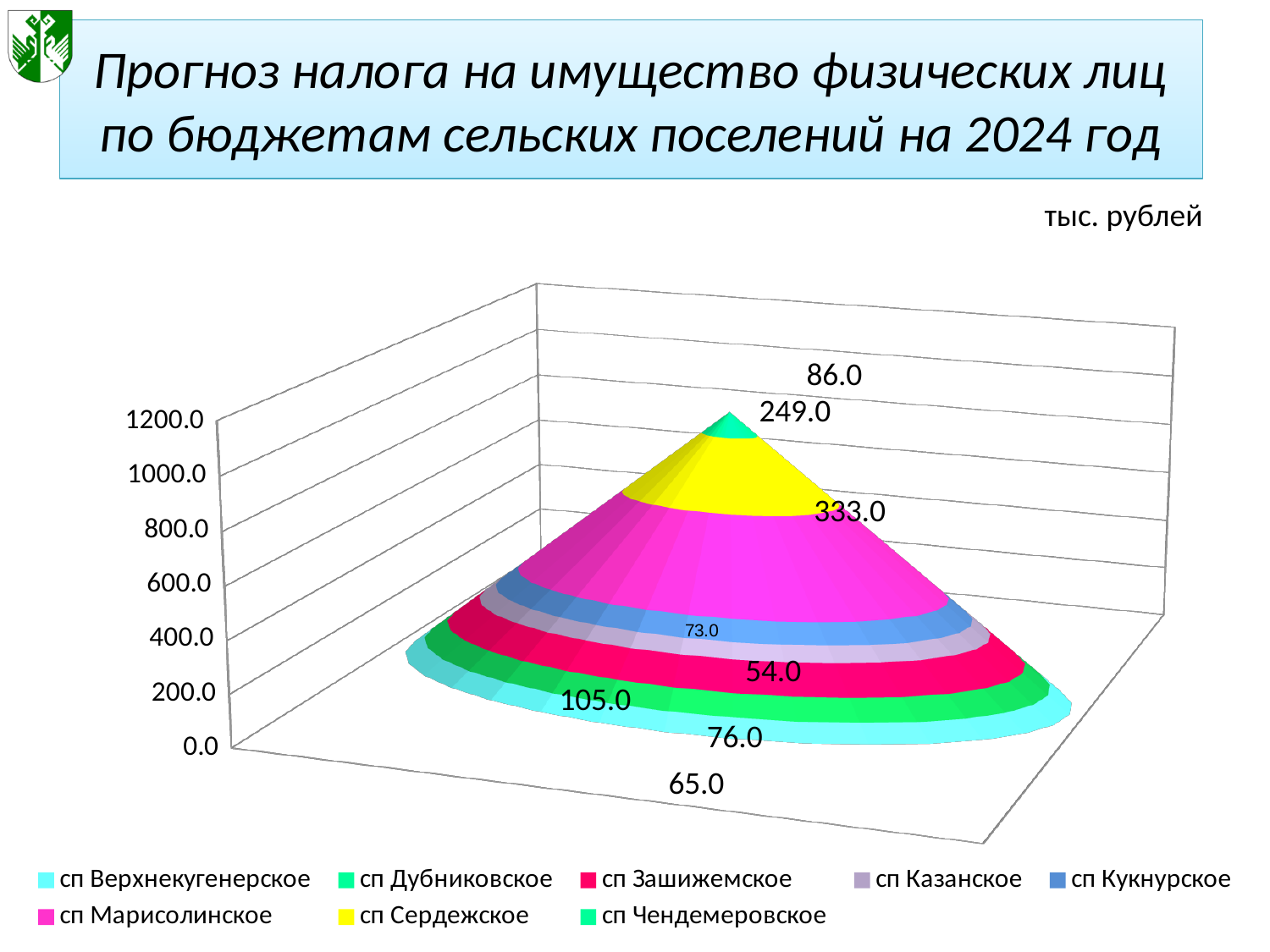
Which is larger, the value for сп Зашижемское or the value for сп Дубниковское? сп Зашижемское What is the value for сп Верхнекугенерское? 65.0 What is the value for сп Сердежское? 249.0 What is the value for сп Казанское? 54.0 What is the total of all the stacked values in the chart? 1041.0 In what units are the values on the chart given? тыс. рублей How many series does the legend list? 8 Which settlement has the lowest forecast value? сп Казанское Which settlement has the highest forecast value? сп Марисолинское What is the difference between the values for сп Марисолинское and сп Сердежское? 84.0 What is the value for сп Марисолинское? 333.0